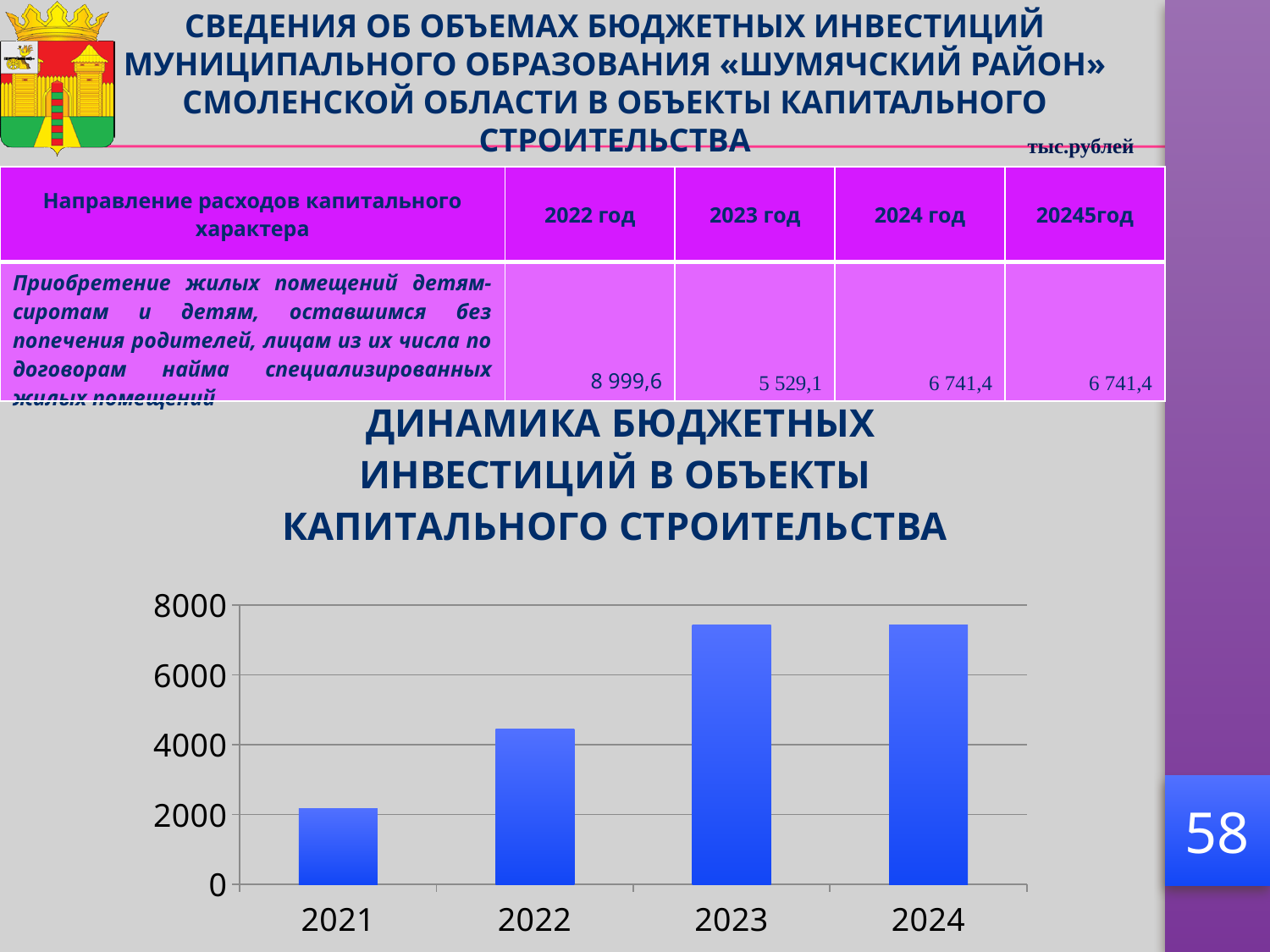
Is the value for 2021 greater or less than 4000? less Is the value for 2022 greater or less than 4000? greater Is the value for 2023 greater or less than 6000? greater Which is larger, the value for 2022 or the value for 2021? 2022 Do the values rise or fall from 2021 to 2023? rise Which is larger, the value for 2023 or the value for 2022? 2023 How many years are shown on the x axis of the chart? 4 What is the highest tick value shown on the vertical axis of the chart? 8000 What kind of chart is shown on the slide? bar chart Which year has the lowest bar in the chart? 2021